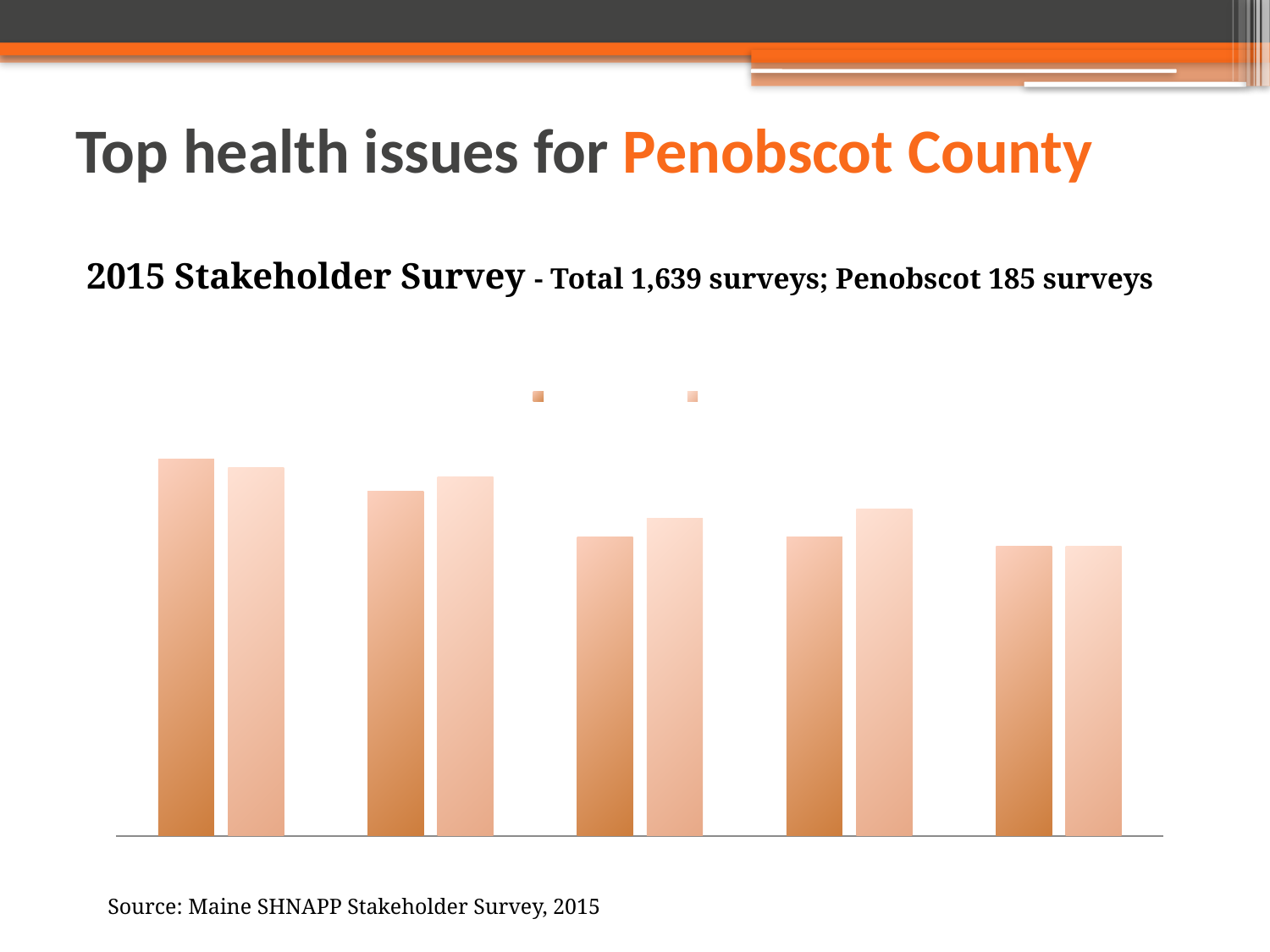
What source is cited below the chart? Maine SHNAPP Stakeholder Survey, 2015 In the leftmost group of bars, is the darker orange bar taller or shorter than the lighter bar? taller What kind of chart is shown on the slide? bar chart Do the bar heights generally rise or fall from left to right across the chart? fall Which group of bars, counting from the left, has the shortest bars in the chart? the fifth (rightmost) group Which group of bars, counting from the left, contains the tallest bar in the chart? the first (leftmost) group How many bars are drawn in each category group? 2 In the second group of bars from the left, is the darker orange bar taller or shorter than the lighter bar? shorter How many series does the chart's legend list? 2 How many groups of bars (categories) are plotted in the chart? 5 What colours are used for the two bar series in the chart? dark orange and light orange